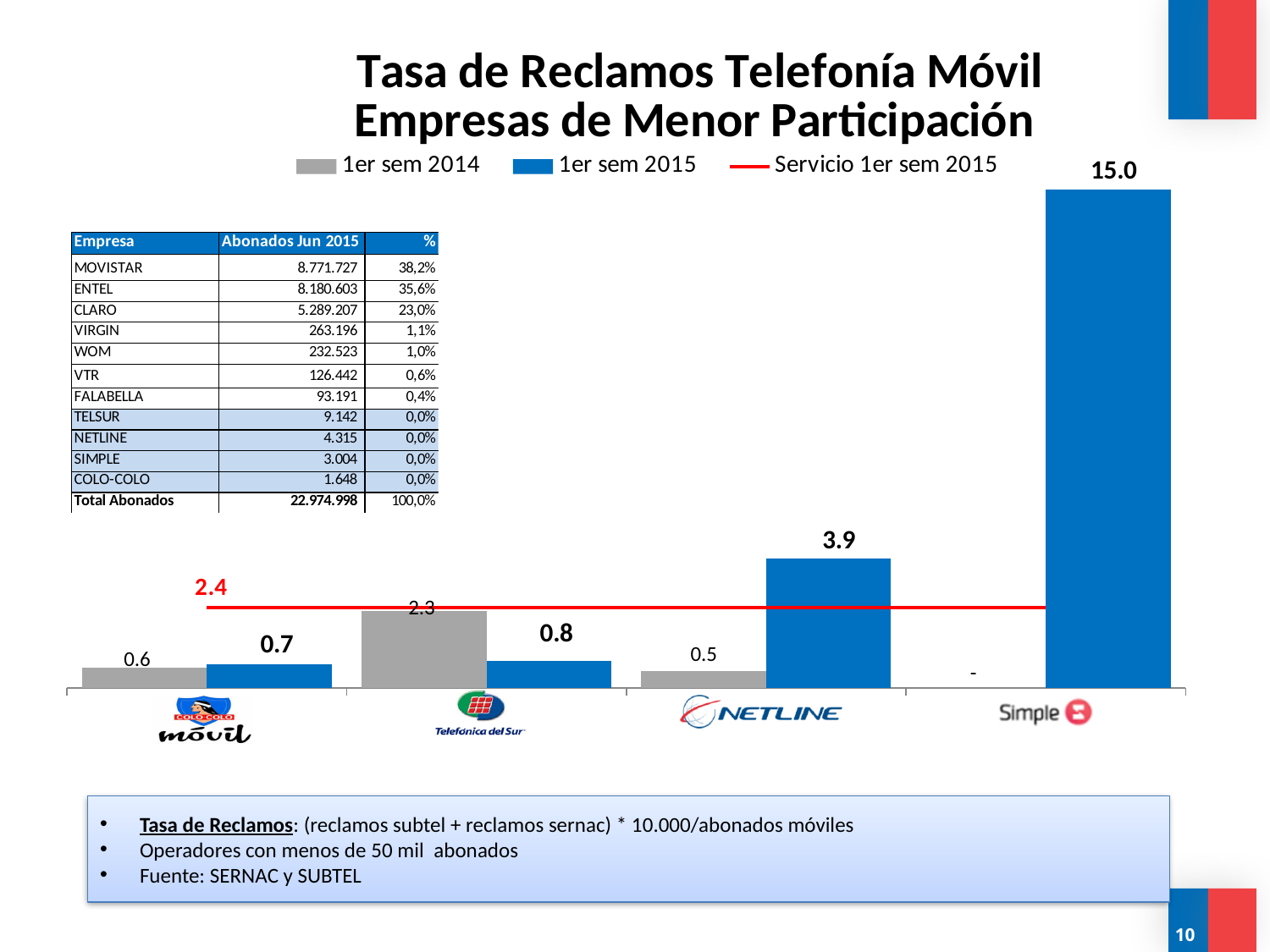
What kind of chart is used to show the complaint rates? Bar chart Which company has the lowest 1er sem 2014 value among those with a plotted bar? Netline What is the difference between the 1er sem 2015 values for Simple and Netline? 11.1 Which company has the highest 1er sem 2015 value? Simple How many series does the chart legend list? 3 What is the 1er sem 2014 value for Colo-Colo móvil? 0.6 What value does the Servicio 1er sem 2015 line show? 2.4 What is the 1er sem 2015 value for Simple? 15.0 What is the 1er sem 2015 value for Netline? 3.9 How many companies are shown on the x axis of the chart? 4 For Telefónica del Sur, which is larger: the 1er sem 2014 value or the 1er sem 2015 value? 1er sem 2014 What is the 1er sem 2014 value for Telefónica del Sur? 2.3